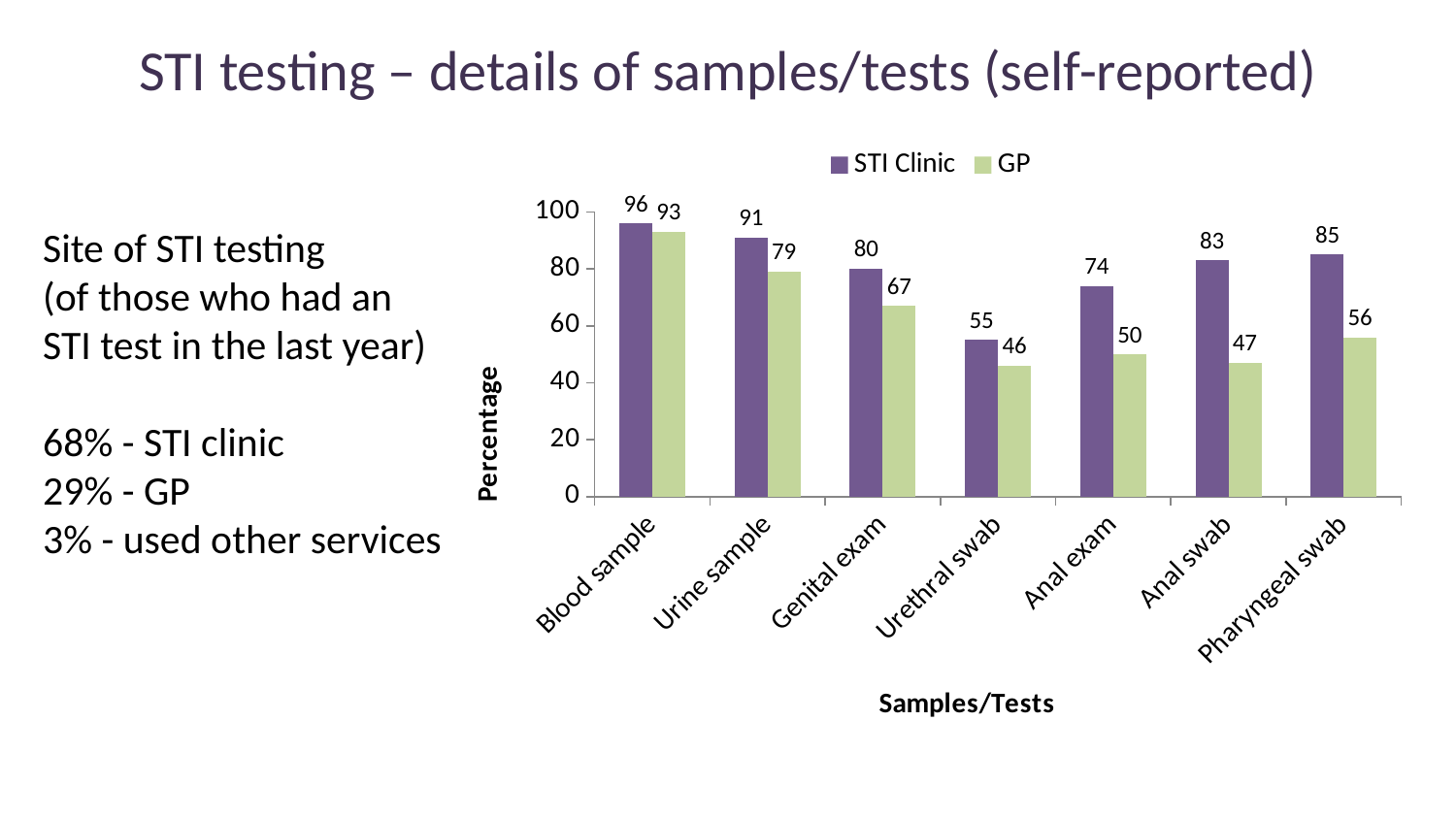
How many categories are shown on the x axis? 7 Is the STI Clinic value for Anal exam greater or less than 60? greater What is the STI Clinic value for Blood sample? 96 What is the difference between the STI Clinic and GP values for Anal swab? 36 What is the GP value for Genital exam? 67 What kind of chart is shown on the slide? Bar chart Which is larger for Urine sample, the STI Clinic value or the GP value? STI Clinic What is the GP value for Pharyngeal swab? 56 How many series does the legend list? 2 Which category has the lowest GP value? Urethral swab What is the label of the y axis? Percentage Which category has the highest STI Clinic value? Blood sample